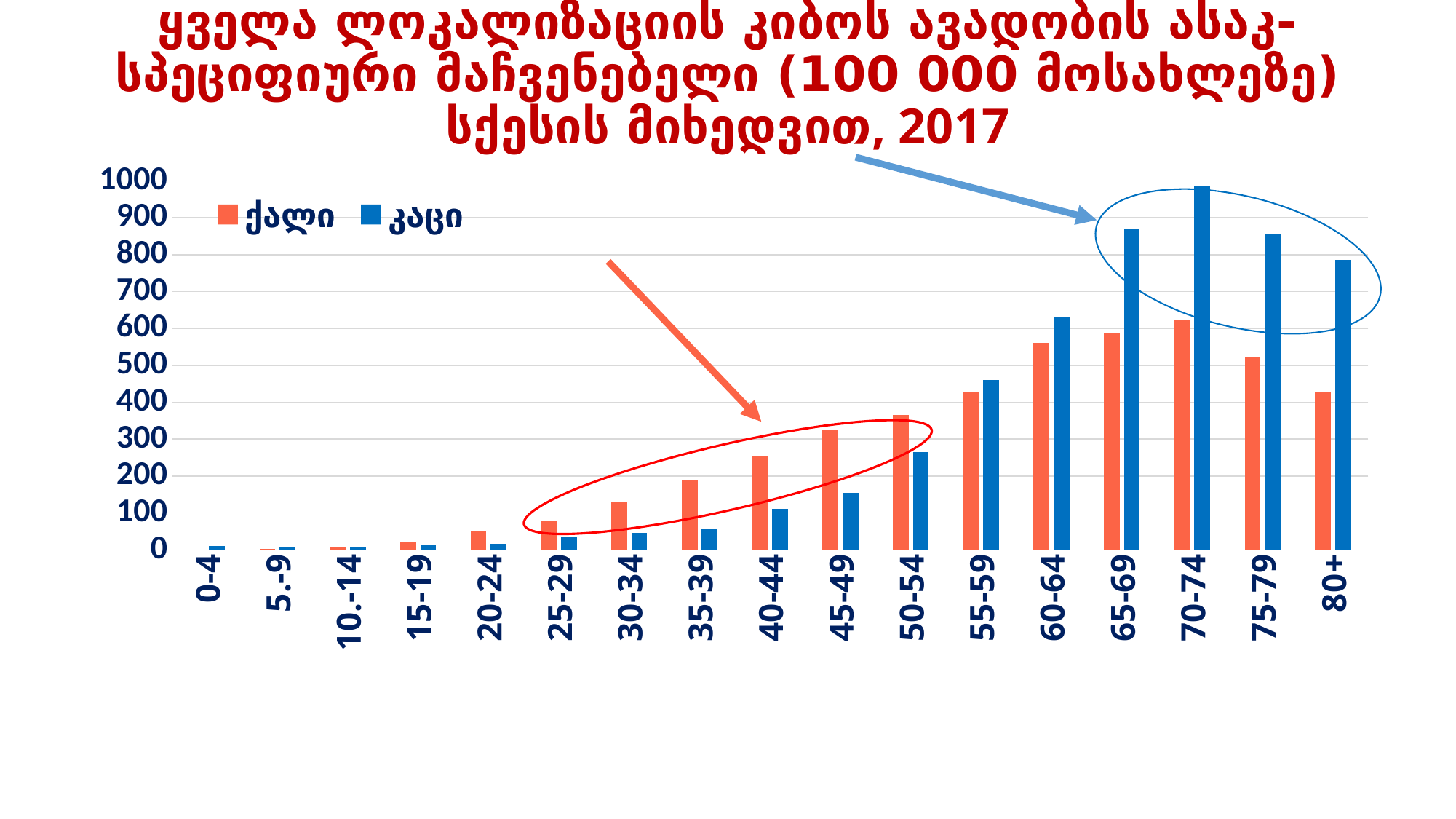
Which age group has the highest value for the ქალი series? 70-74 How many age groups are shown on the x axis? 17 In the 65-69 age group, which series has the larger value, ქალი or კაცი? კაცი What kind of chart is shown on the slide? bar chart Is the value for ქალი in the 40-44 age group greater or less than 200? greater Do the values for the ქალი series rise or fall from the 25-29 age group to the 50-54 age group? rise Which age group has the highest value for the კაცი series? 70-74 What colour are the bars for the ქალი series? orange How many series does the legend list? 2 Is the value for კაცი in the 45-49 age group greater or less than 200? less Is the value for კაცი in the 70-74 age group greater or less than 900? greater In the 45-49 age group, which series has the larger value, ქალი or კაცი? ქალი